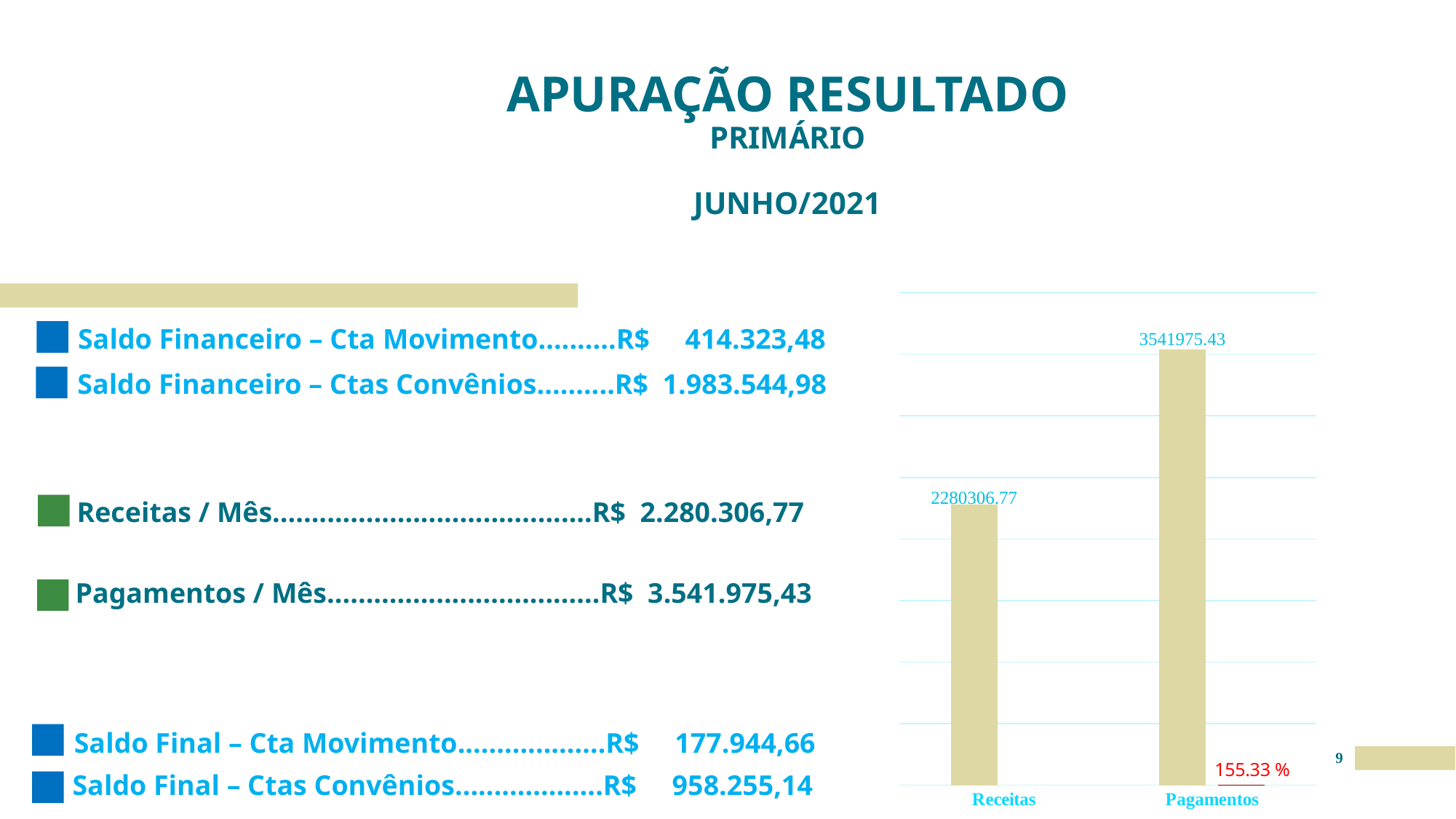
What is the value of the Receitas bar in the chart? 2280306.77 Which category has the lowest bar in the chart? Receitas What type of chart is shown on the slide? bar chart Do the bar values rise or fall from Receitas to Pagamentos? rise What colour are the bars in the chart? beige How many bars are plotted in the chart? 2 Which category has the highest bar in the chart? Pagamentos What percentage is printed in red next to the Pagamentos bar? 155.33 % What is the difference between the Pagamentos and Receitas values in the chart? 1261668.66 Which is larger in the chart, Receitas or Pagamentos? Pagamentos What is the value of the Pagamentos bar in the chart? 3541975.43